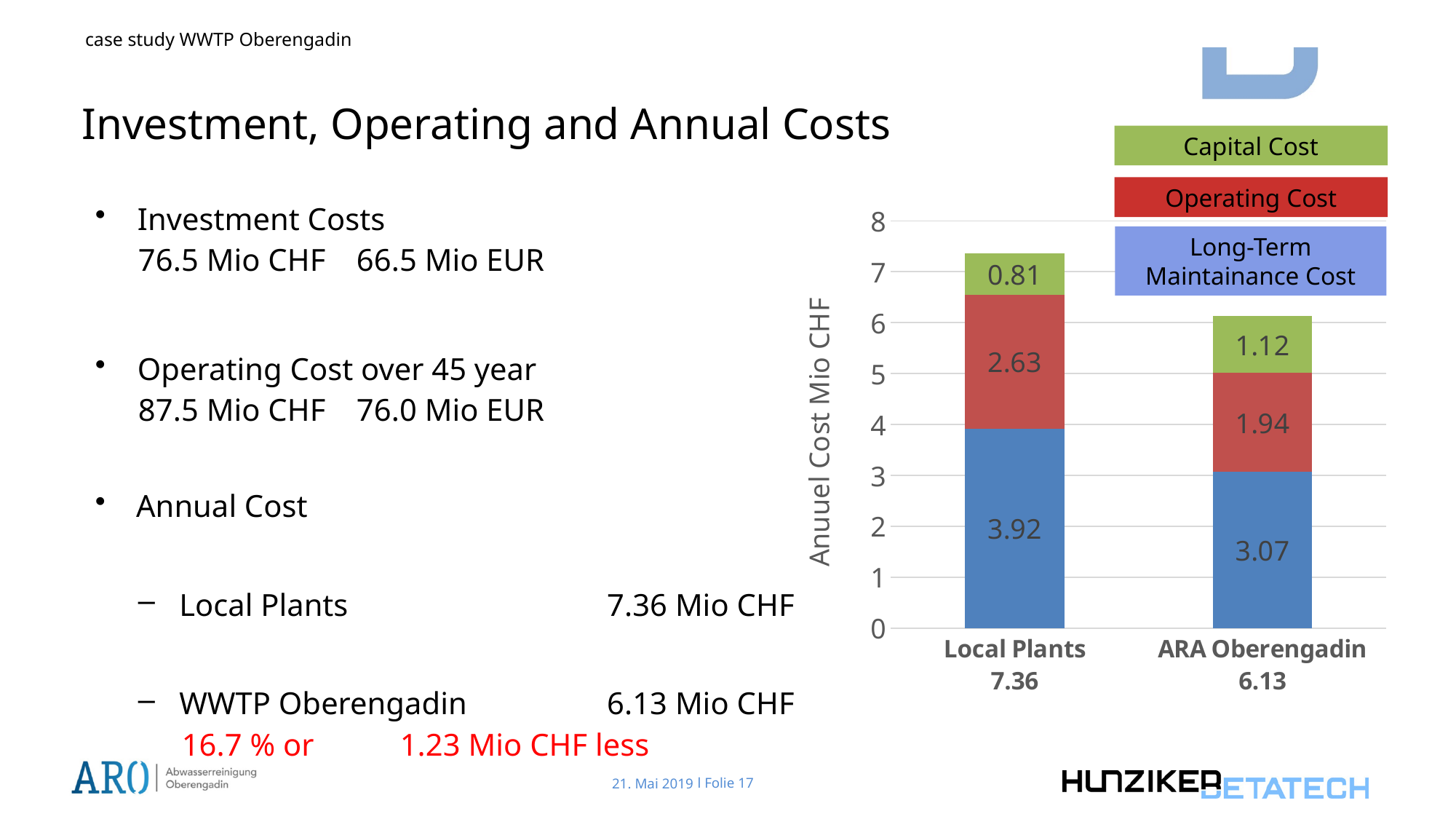
What is the Long-Term Maintainance Cost value for ARA Oberengadin? 3.07 What type of chart is shown on the slide? Stacked bar chart What is the Long-Term Maintainance Cost value for Local Plants? 3.92 What is the total annual cost shown for the Local Plants bar? 7.36 What is the total annual cost shown for the ARA Oberengadin bar? 6.13 What is the difference in Operating Cost between Local Plants and ARA Oberengadin? 0.69 Which category has the higher total annual cost, Local Plants or ARA Oberengadin? Local Plants Which category has the higher Capital Cost? ARA Oberengadin How many series does the legend list? 3 What is the Capital Cost value for ARA Oberengadin? 1.12 What is the label of the vertical axis? Anuuel Cost Mio CHF What is the Operating Cost value for Local Plants? 2.63